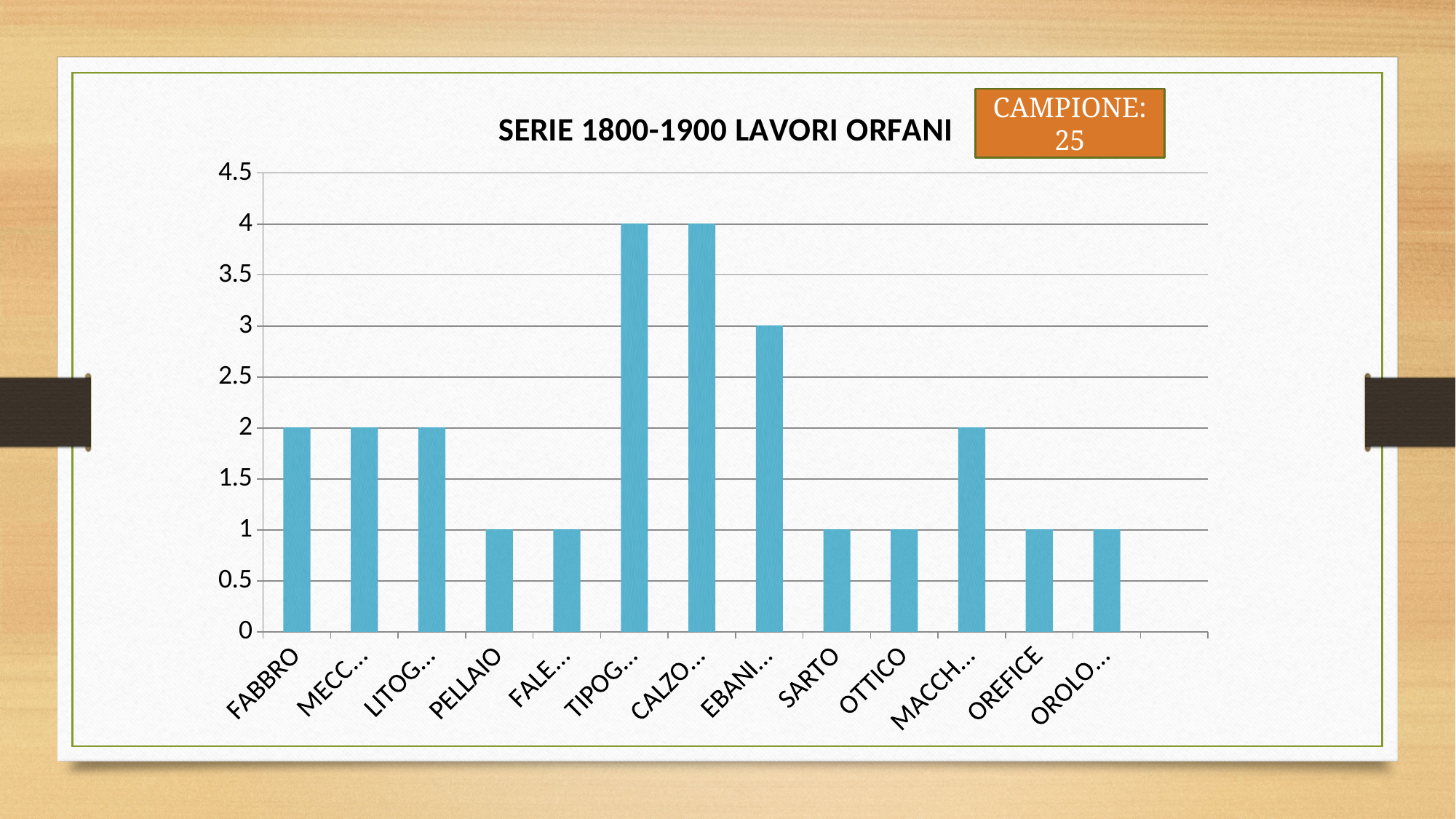
What is the value for OTTICO? 1 How many categories are shown on the x axis? 13 What kind of chart is shown on the slide? Bar chart What is the value for PELLAIO? 1 What is the value for FABBRO? 2 What sample size (CAMPIONE) is stated in the box next to the chart title? 25 What is the highest value reached by any bar in the chart? 4 What is the value for SARTO? 1 What is the title of the chart? SERIE 1800-1900 LAVORI ORFANI Which is larger, the value for FABBRO or the value for SARTO? FABBRO What is the value for OREFICE? 1 What is the difference between the values for FABBRO and PELLAIO? 1